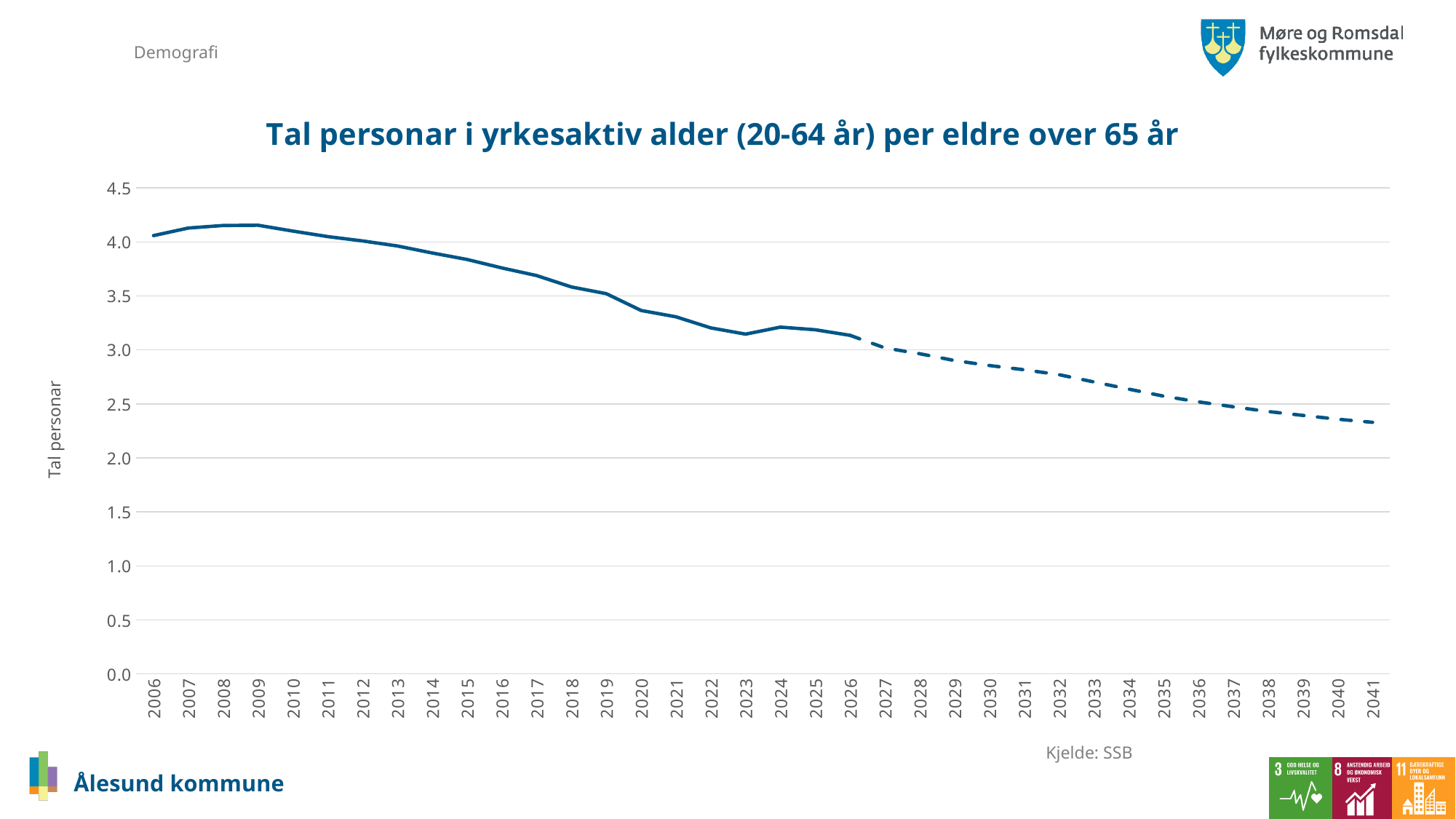
What is the label on the vertical axis of the chart? Tal personar Is the value for 2041 greater or less than 2.5? less Is the value for 2023 greater or less than 3.0? greater Is the value for 2014 greater or less than 4.0? less Which year has the lowest value on the chart? 2041 Which year has the larger value, 2010 or 2020? 2010 Do the values generally rise or fall from 2009 to 2041? Fall How many years are shown along the x axis of the chart? 36 What is the title of the chart? Tal personar i yrkesaktiv alder (20-64 år) per eldre over 65 år What kind of chart is shown on the slide? Line chart